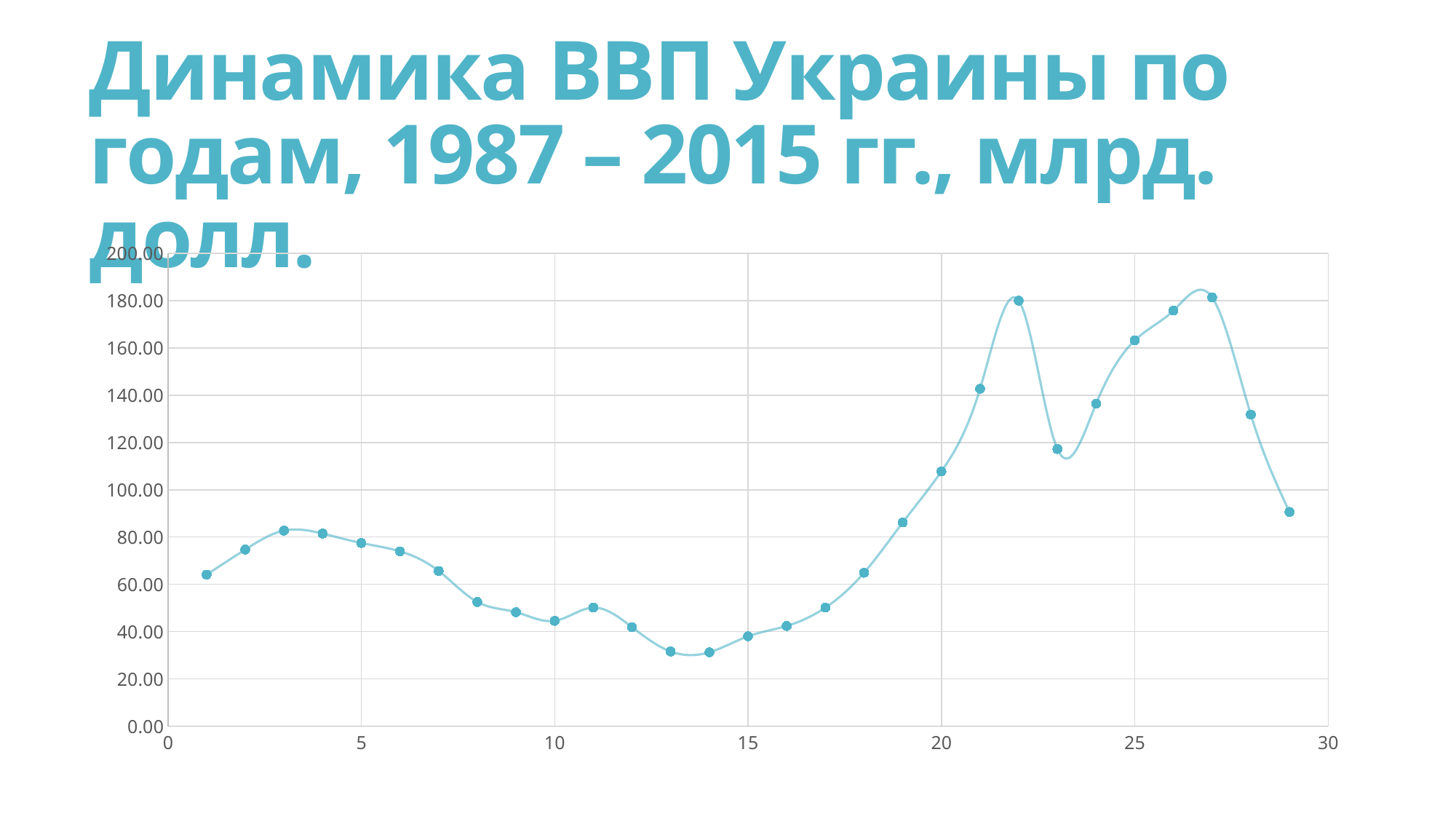
Is the value at x = 23 greater or less than 140.00? less What is the title of the slide containing the chart? Динамика ВВП Украины по годам, 1987 – 2015 гг., млрд. долл. Is the value at x = 13 greater or less than 40.00? less What kind of chart is shown on the slide? line chart Is the value at x = 20 greater or less than 100.00? greater Which is larger, the value at x = 22 or the value at x = 23? x = 22 How many data points are plotted on the chart? 29 Which is larger, the value at x = 3 or the value at x = 14? x = 3 Do the values rise or fall between x = 14 and x = 22? rise